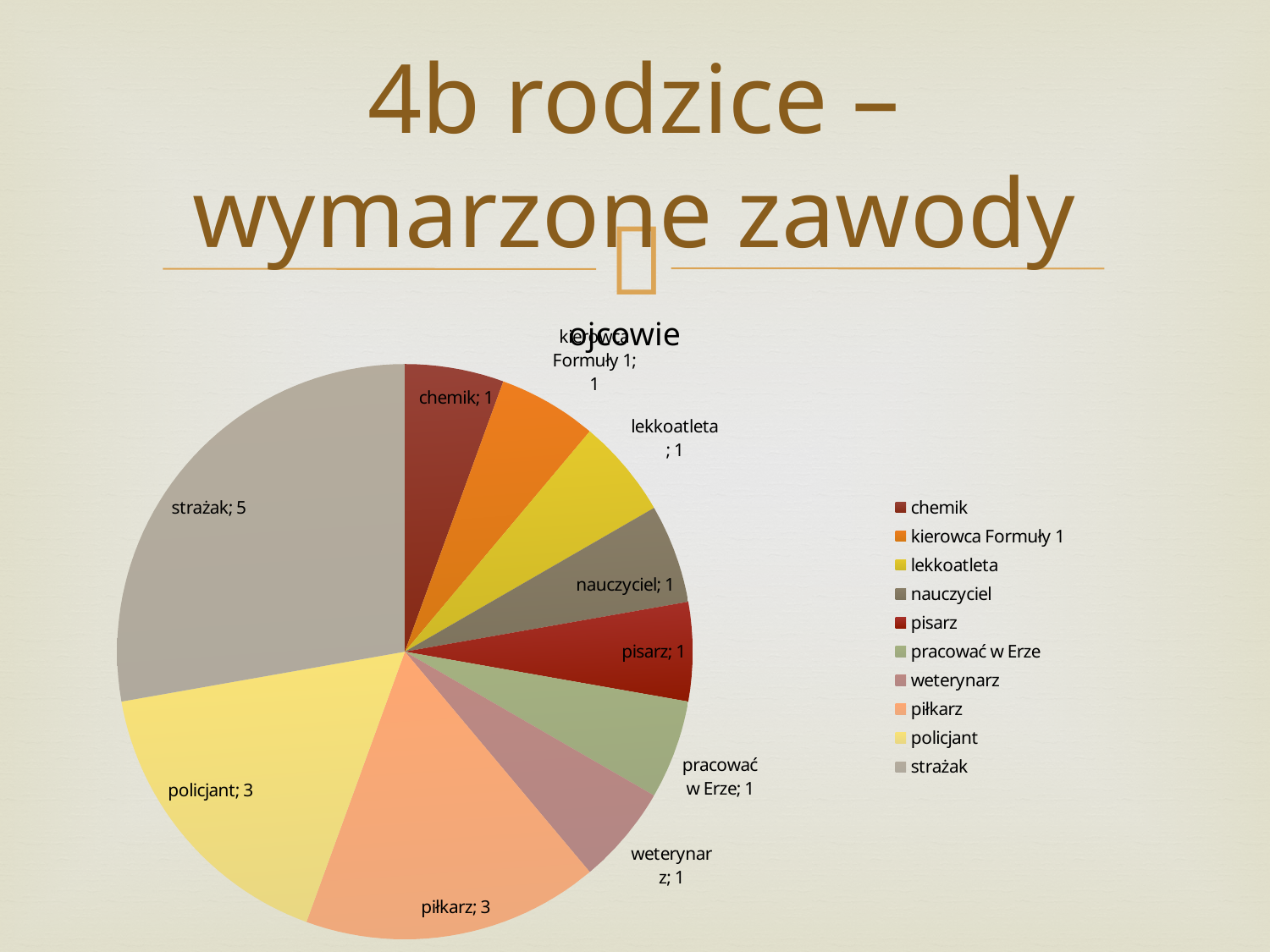
Which is larger, the value for piłkarz or the value for weterynarz? piłkarz Which category has the largest slice of the pie? strażak What is the value for policjant? 3 What is the difference between the values for strażak and policjant? 2 What is the total of all the values in the pie chart? 18 What is the value for piłkarz? 3 What is the value for chemik? 1 What is the title of the chart? ojcowie How many categories does the pie chart have? 10 What kind of chart is shown on the slide? pie chart What is the value for strażak? 5 What colour is the strażak slice? grey